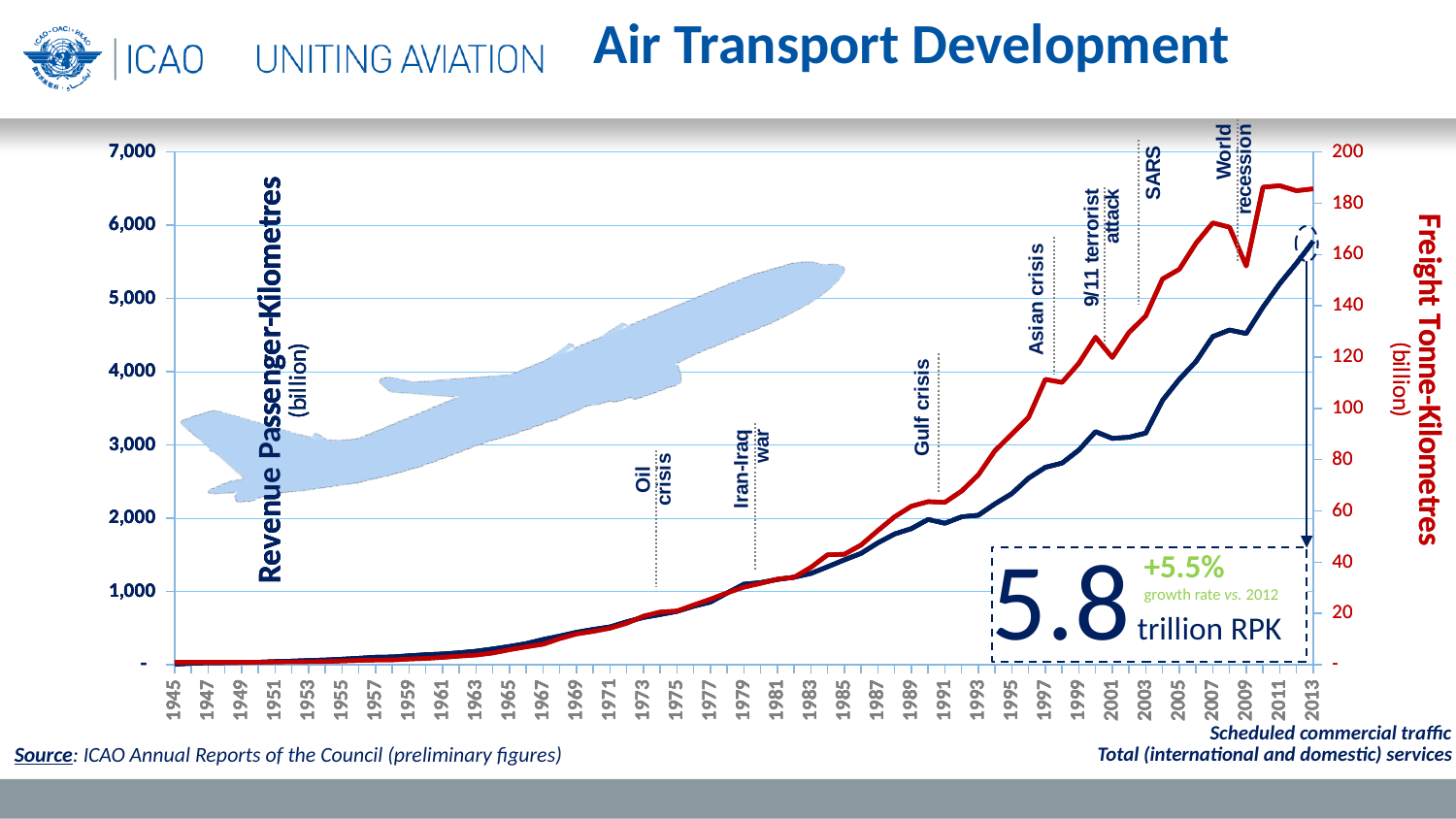
What kind of chart is shown on the slide? line chart Do Revenue Passenger-Kilometres generally rise or fall from 1945 to 2013? rise Which series is plotted in red? Freight Tonne-Kilometres Is the Freight Tonne-Kilometres value for 1997 greater or less than 100? greater How many historical events are annotated on the chart? 7 Is the Revenue Passenger-Kilometres value for 1997 greater or less than 3,000? less Is the Revenue Passenger-Kilometres value for 2007 greater or less than 4,000? greater What value of RPK is highlighted for 2013 in the callout box? 5.8 trillion RPK Do Freight Tonne-Kilometres generally rise or fall from 1945 to 2013? rise What is the first year shown on the x axis? 1945 What growth rate vs. 2012 is shown in the callout box? +5.5%